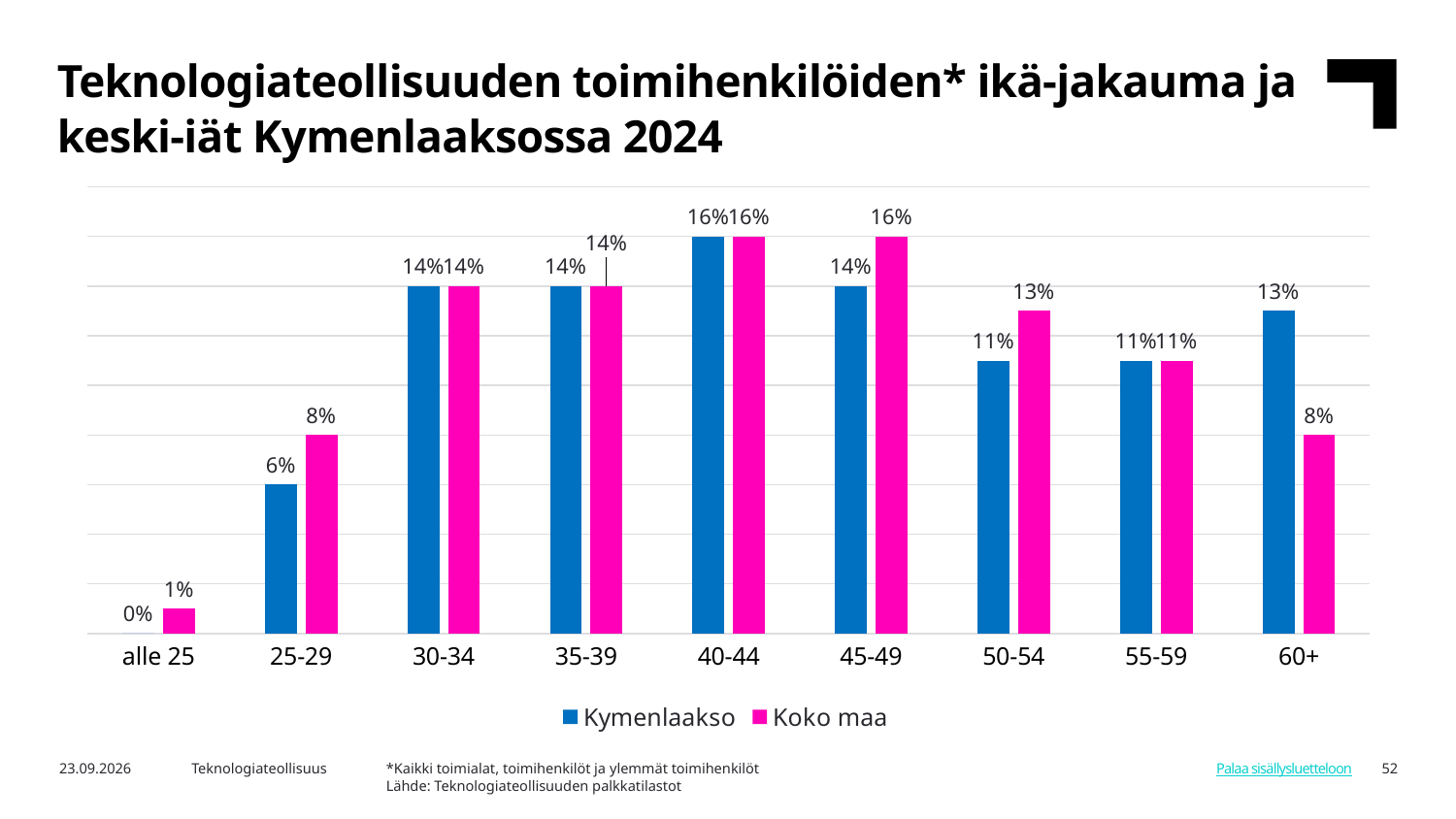
Which age group has the highest value for Kymenlaakso? 40-44 What is the value for Koko maa in the 25-29 age group? 8% What is the difference between Koko maa and Kymenlaakso in the 50-54 age group? 2% What is the value for Kymenlaakso in the 60+ age group? 13% In the 45-49 age group, which series has the larger value, Kymenlaakso or Koko maa? Koko maa What is the value for Kymenlaakso in the 45-49 age group? 14% What kind of chart is shown on the slide? Bar chart Which age group has the lowest value for Koko maa? alle 25 In the 60+ age group, which series has the larger value, Kymenlaakso or Koko maa? Kymenlaakso What is the difference between Kymenlaakso and Koko maa in the 60+ age group? 5% How many age groups are shown on the x axis? 9 How many series does the legend list? 2